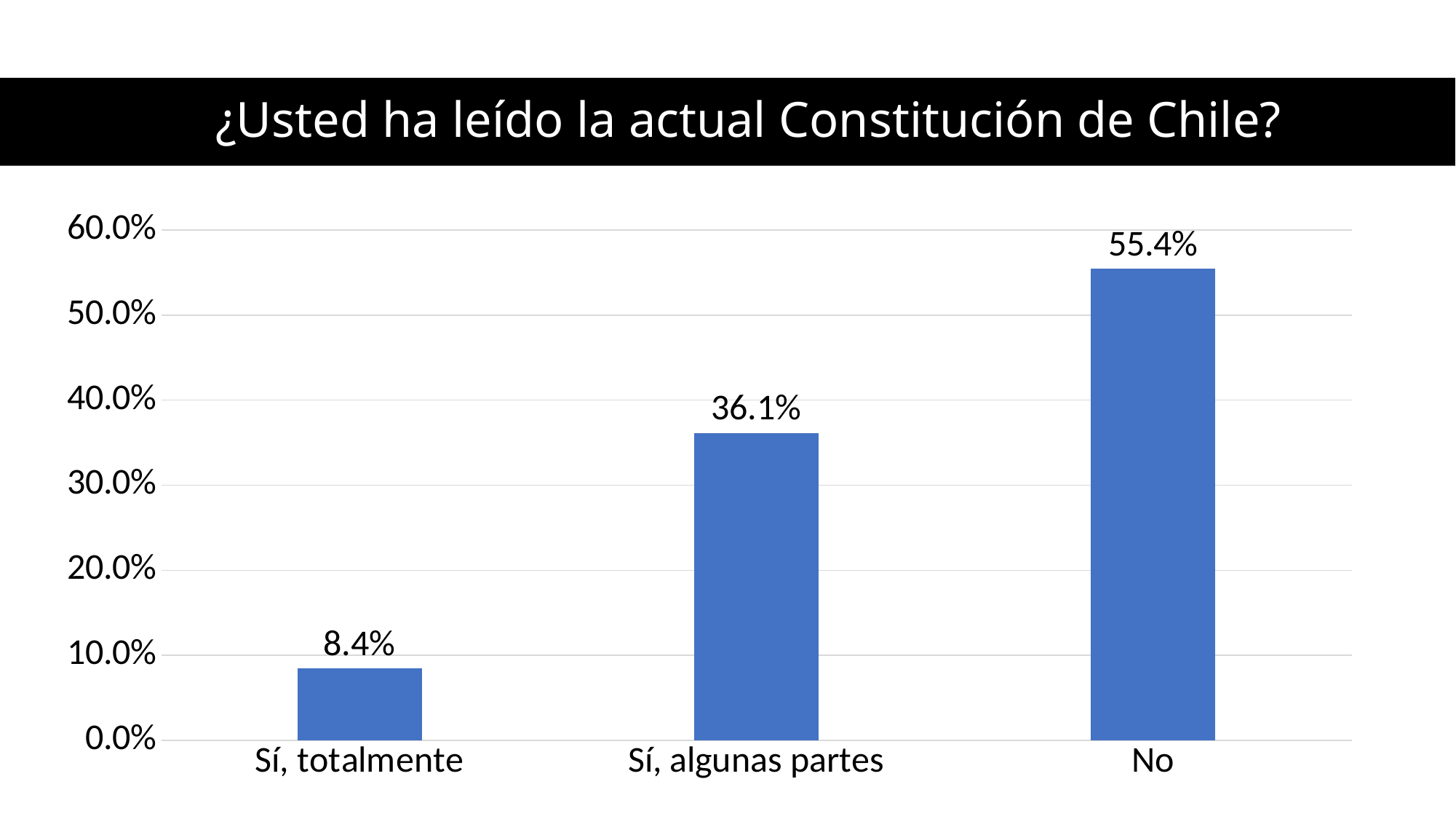
Which category has the lowest value? Sí, totalmente Which category has the highest value? No What is the difference between the values for "No" and "Sí, algunas partes"? 19.3% What is the value for "Sí, algunas partes"? 36.1% What is the difference between the values for "Sí, algunas partes" and "Sí, totalmente"? 27.7% How many categories are shown on the chart? 3 What is the value for "No"? 55.4% Is the value for "No" greater or less than 50.0%? greater What is the title of the chart? ¿Usted ha leído la actual Constitución de Chile? Which is larger, the value for "Sí, totalmente" or the value for "Sí, algunas partes"? Sí, algunas partes What is the value for "Sí, totalmente"? 8.4% What kind of chart is shown on the slide? Bar chart